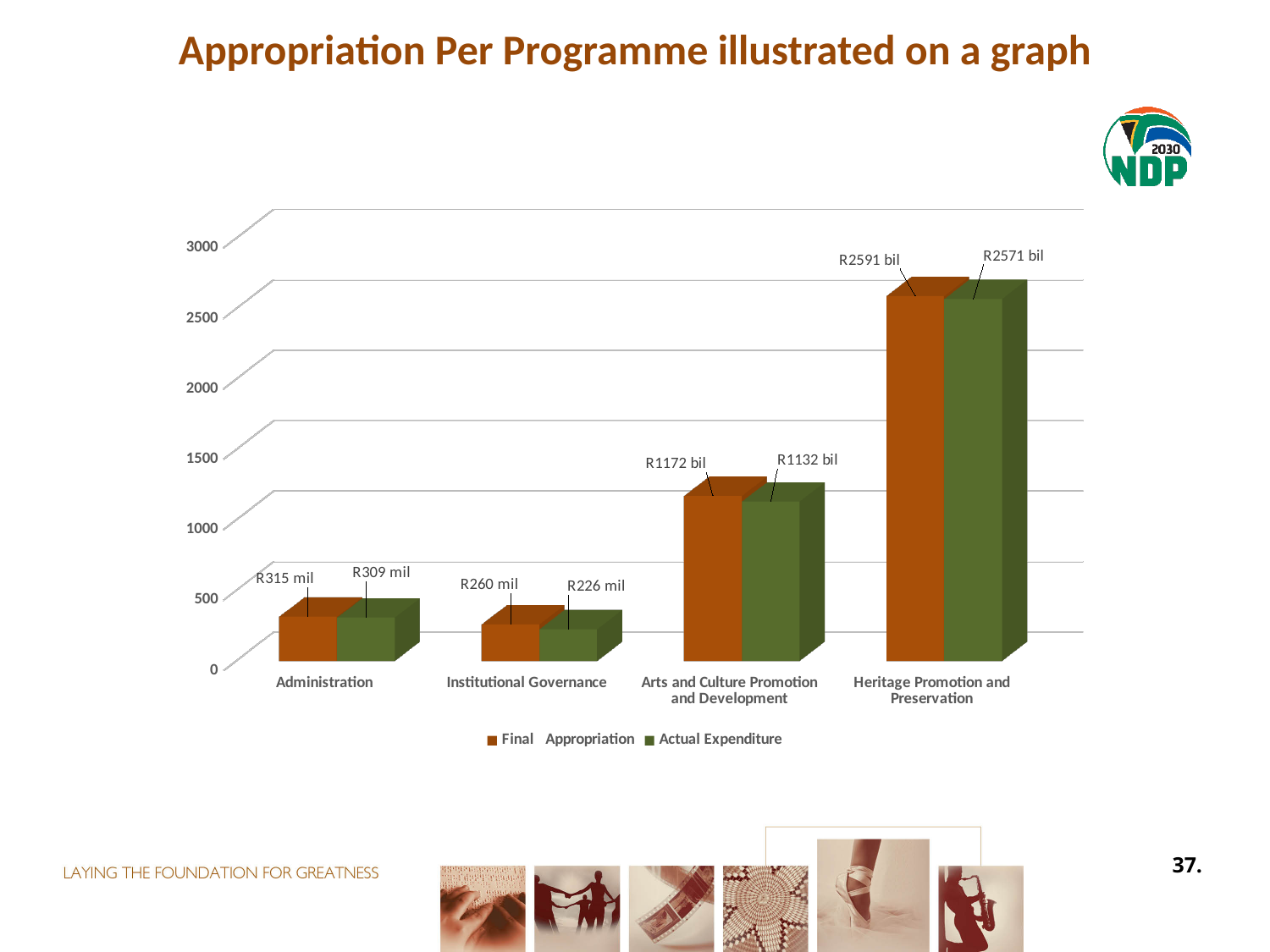
Which is larger for Arts and Culture Promotion and Development: Final Appropriation or Actual Expenditure? Final Appropriation What is the Final Appropriation value for Administration? R315 mil Is the Final Appropriation for Heritage Promotion and Preservation greater or less than 2500? greater What is the Actual Expenditure value for Heritage Promotion and Preservation? R2571 bil How many series does the legend list? 2 Which programme has the highest Final Appropriation? Heritage Promotion and Preservation How many programmes are shown on the x axis? 4 What kind of chart is shown on the slide? Bar chart What is the Final Appropriation value for Arts and Culture Promotion and Development? R1172 bil What is the difference between Final Appropriation and Actual Expenditure for Institutional Governance? R34 mil What is the Actual Expenditure value for Institutional Governance? R226 mil Which programme has the lowest Actual Expenditure? Institutional Governance